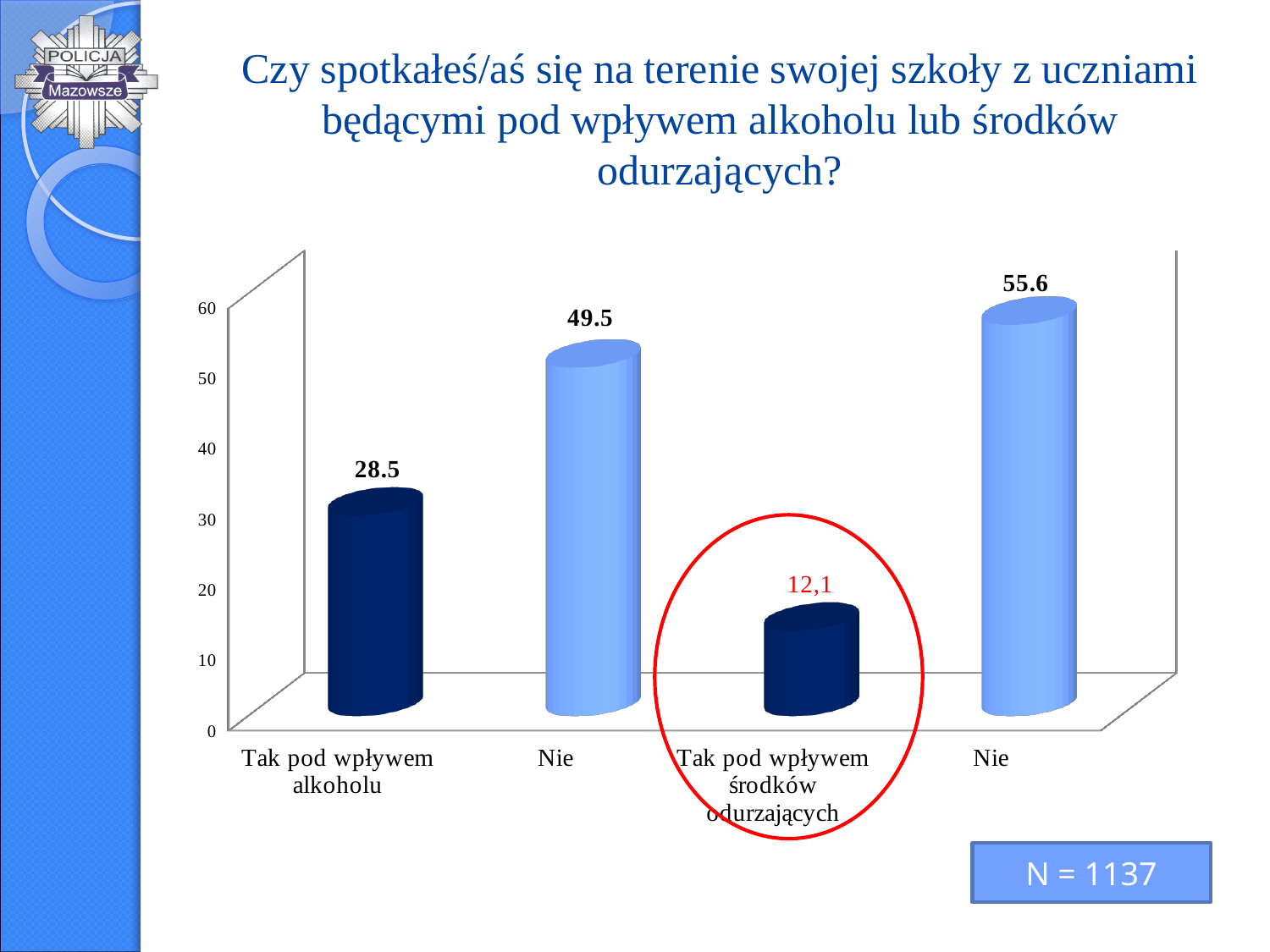
What is the difference between the value for "Tak pod wpływem alkoholu" and the value for "Tak pod wpływem środków odurzających"? 16.4 Which bar is circled in red on the chart? Tak pod wpływem środków odurzających Is the value for "Tak pod wpływem alkoholu" greater or less than 30? less What kind of chart is shown on the slide? bar chart Which category has the lowest value? Tak pod wpływem środków odurzających What is the value for "Tak pod wpływem środków odurzających"? 12,1 What is the value for "Tak pod wpływem alkoholu"? 28.5 What is the value of the rightmost bar, labelled "Nie"? 55.6 How many bars are shown in the chart? 4 Which category has the highest value? Nie (rightmost bar) What is the value of the second bar from the left, labelled "Nie"? 49.5 Which is larger: the value for "Tak pod wpływem alkoholu" or the value for "Tak pod wpływem środków odurzających"? Tak pod wpływem alkoholu